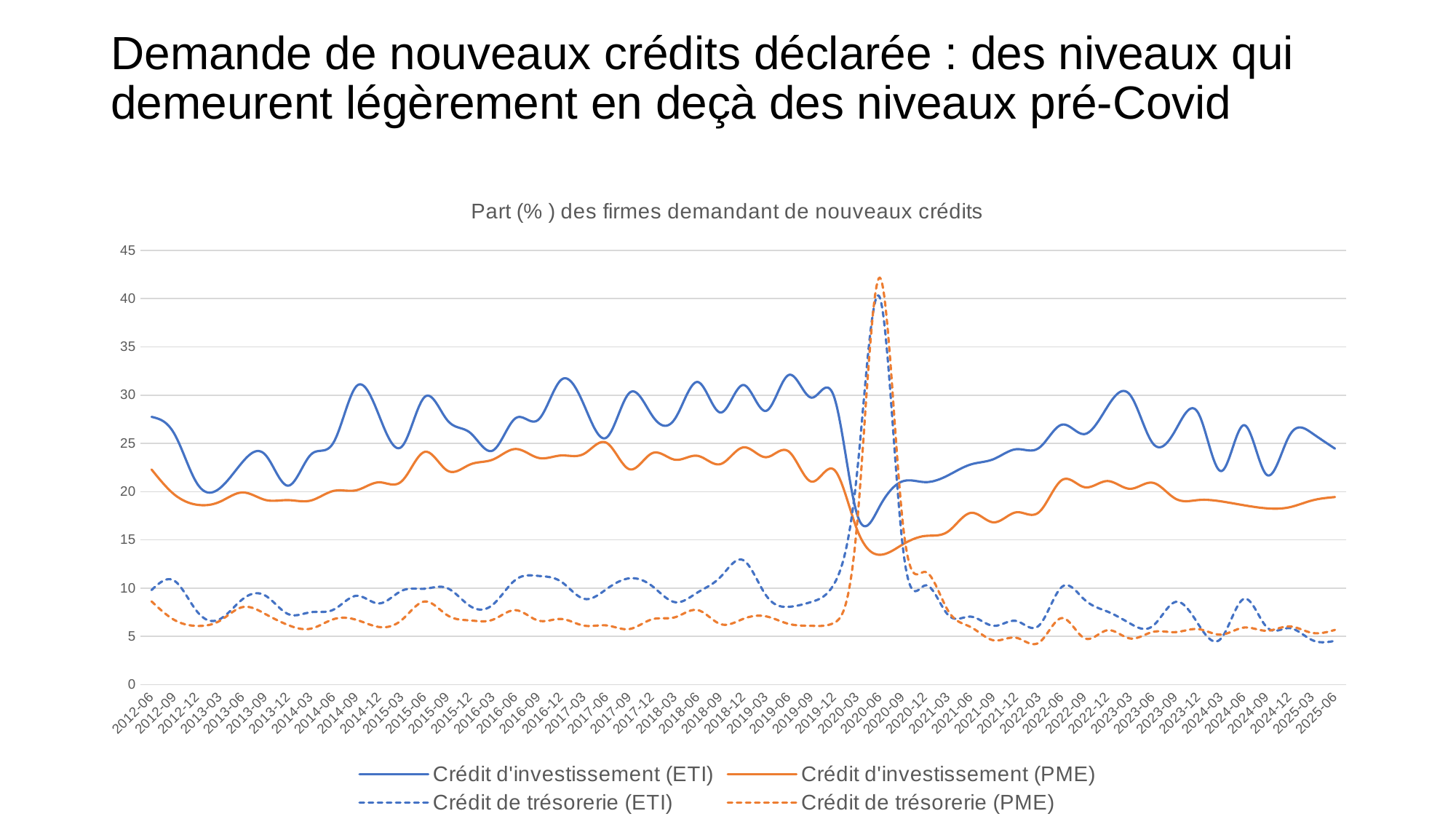
At 2020-06, which is higher: Crédit de trésorerie (PME) or Crédit d'investissement (PME)? Crédit de trésorerie (PME) Does Crédit d'investissement (PME) rise or fall between 2020-06 and 2022-06? rise Is the value for Crédit de trésorerie (PME) at 2020-06 greater or less than 40? greater In which period does Crédit de trésorerie (PME) reach its peak? 2020-06 Is the value for Crédit d'investissement (PME) at 2020-06 greater or less than 15? less At 2012-06, which is higher: Crédit d'investissement (ETI) or Crédit d'investissement (PME)? Crédit d'investissement (ETI) Which series are drawn with dashed lines? Crédit de trésorerie (ETI) and Crédit de trésorerie (PME) What is the title of the chart? Part (% ) des firmes demandant de nouveaux crédits Is the value for Crédit d'investissement (ETI) at 2012-06 greater or less than 25? greater How many series does the legend list? 4 What kind of chart is shown on the slide? line chart